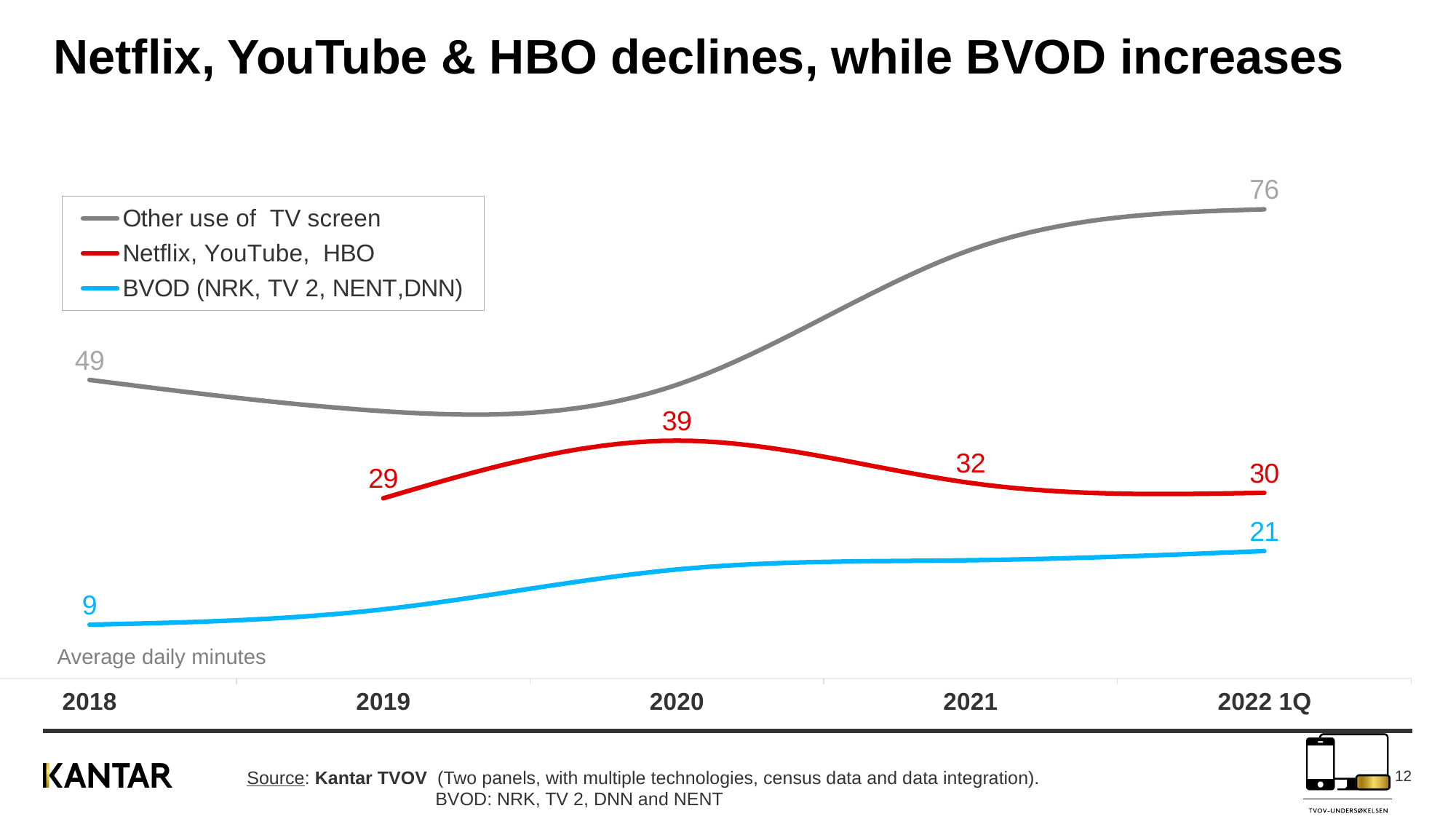
What is the value for Other use of TV screen in 2022 1Q? 76 What is the value for Netflix, YouTube, HBO in 2019? 29 What type of chart is shown on the slide? Line chart What is the value for BVOD (NRK, TV 2, NENT, DNN) in 2018? 9 What is the value for Netflix, YouTube, HBO in 2020? 39 What is the difference between the Netflix, YouTube, HBO values in 2020 and 2022 1Q? 9 How many time points are shown on the x axis? 5 How many series does the legend list? 3 Does the BVOD (NRK, TV 2, NENT, DNN) series rise or fall from 2018 to 2022 1Q? Rise Which series has the higher value in 2022 1Q: Netflix, YouTube, HBO or BVOD (NRK, TV 2, NENT, DNN)? Netflix, YouTube, HBO What is the difference between the Other use of TV screen values in 2022 1Q and 2018? 27 In which year does the Netflix, YouTube, HBO series reach its highest labelled value? 2020